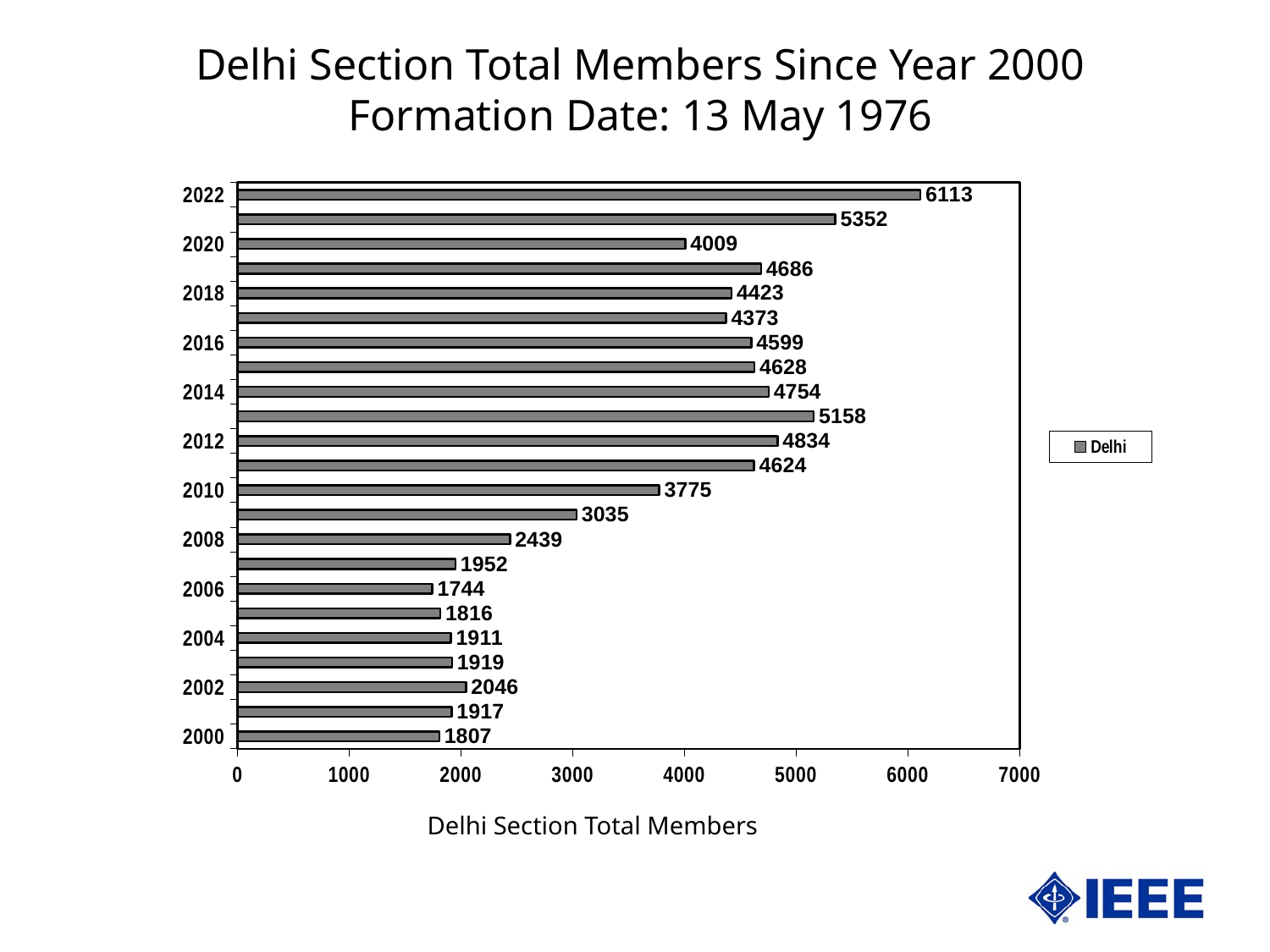
How many series does the legend list? 1 What is the value for 2016? 4599 Which year has the highest value? 2022 Which year has the lowest value? 2006 Is the value for 2008 greater or less than 2000? greater What is the value for 2010? 3775 What kind of chart is shown? bar chart How many bars are shown in the chart? 23 What is the value for 2000? 1807 Which is larger, the value for 2012 or the value for 2014? 2012 What is the value for 2022? 6113 What is the difference between the values for 2022 and 2020? 2104